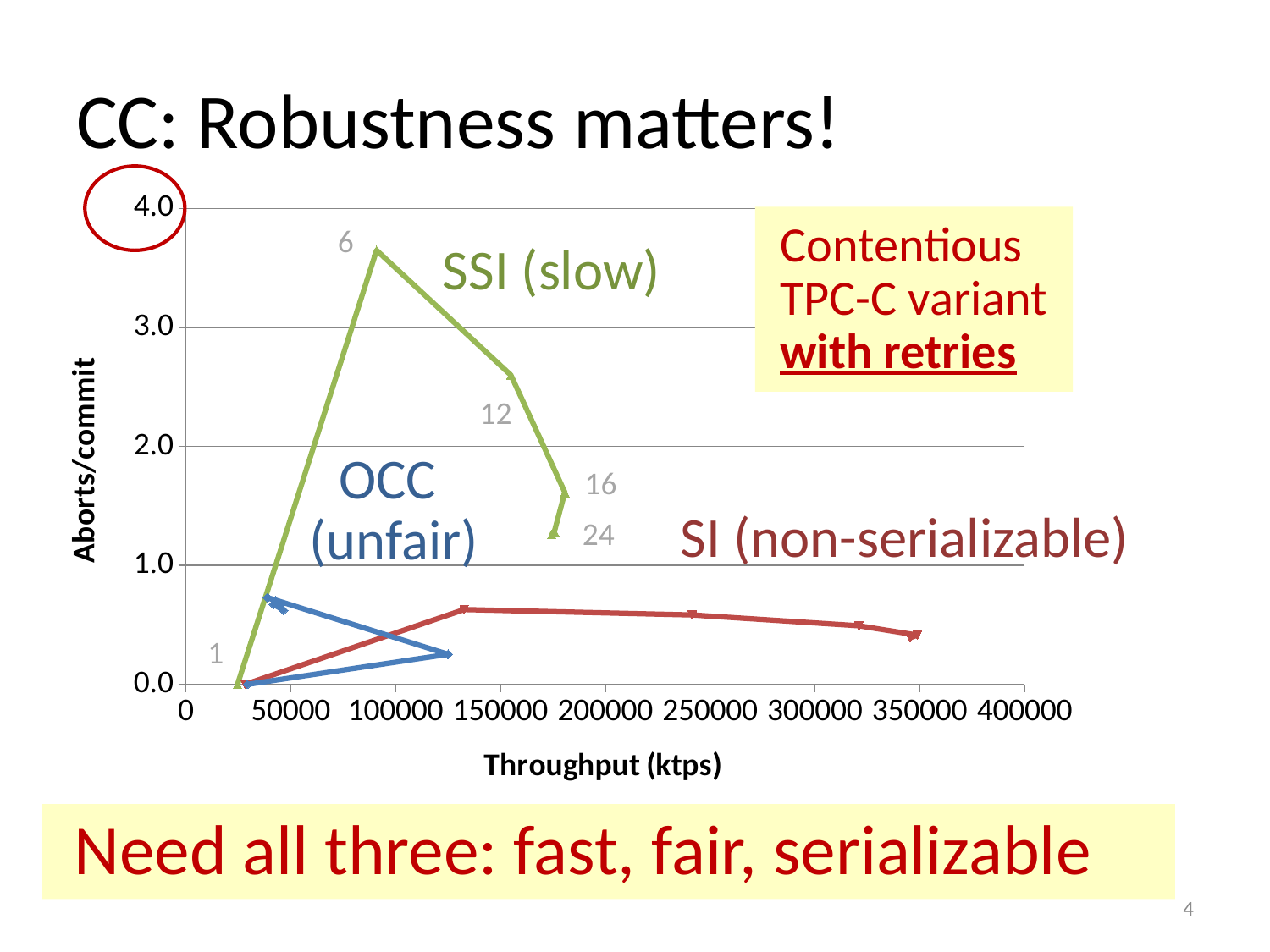
Is the maximum throughput reached by SSI (slow) greater or less than 200000? less Is the maximum throughput reached by SI (non-serializable) greater or less than 300000? greater Which series reaches the highest throughput? SI (non-serializable) What kind of chart is shown on the slide? line chart Which series reaches the highest aborts/commit value? SSI (slow) Is the peak aborts/commit value for SSI (slow) greater or less than 3.0? greater What is the title of the y axis? Aborts/commit For SI (non-serializable), do aborts/commit rise or fall as throughput increases from 150000 to 350000? fall Which series has a higher peak aborts/commit, SSI (slow) or SI (non-serializable)? SSI (slow) How many series are plotted on the chart? 3